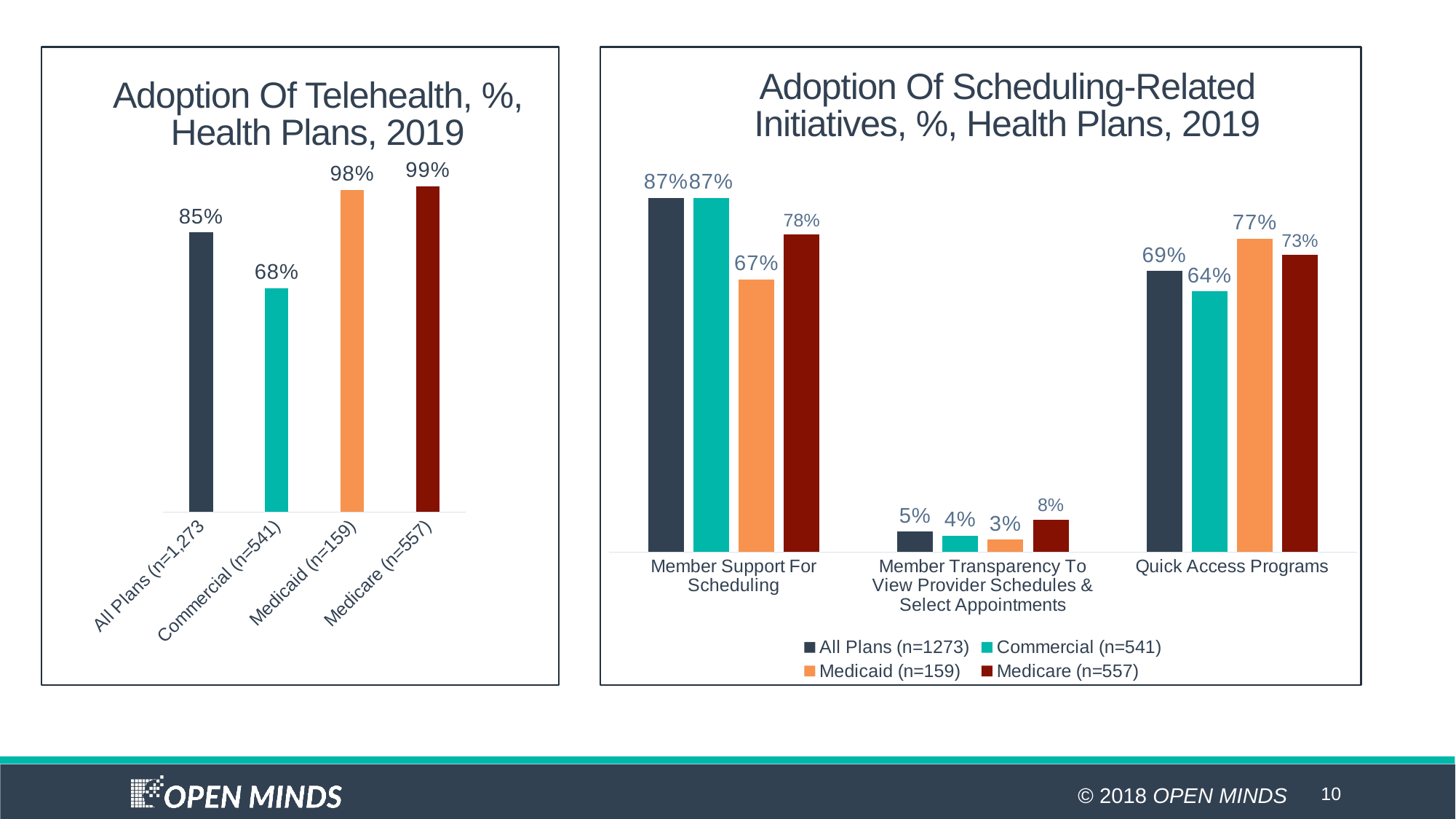
In the 'Adoption Of Telehealth' chart, which category has the lowest value? Commercial (n=541) In the 'Adoption Of Scheduling-Related Initiatives' chart, what is the difference between the Medicare and Medicaid values for Member Support For Scheduling? 11% In the 'Adoption Of Telehealth' chart, which category has the highest value? Medicare (n=557) In the 'Adoption Of Scheduling-Related Initiatives' chart, what is the Medicaid (n=159) value for Quick Access Programs? 77% In the 'Adoption Of Scheduling-Related Initiatives' chart, which series has the lowest value for Member Support For Scheduling? Medicaid (n=159) In the 'Adoption Of Telehealth' chart, what is the value for Commercial (n=541)? 68% In the 'Adoption Of Telehealth' chart, how many categories are shown? 4 What kind of chart is the 'Adoption Of Scheduling-Related Initiatives' chart? Bar chart In the 'Adoption Of Scheduling-Related Initiatives' chart, is the All Plans value for Quick Access Programs larger or the Commercial value? All Plans In the 'Adoption Of Telehealth' chart, what is the difference between the Medicaid (n=159) and All Plans (n=1,273) values? 13% In the 'Adoption Of Scheduling-Related Initiatives' chart, what is the Medicare (n=557) value for Member Transparency To View Provider Schedules & Select Appointments? 8% In the 'Adoption Of Scheduling-Related Initiatives' chart, how many series does the legend list? 4